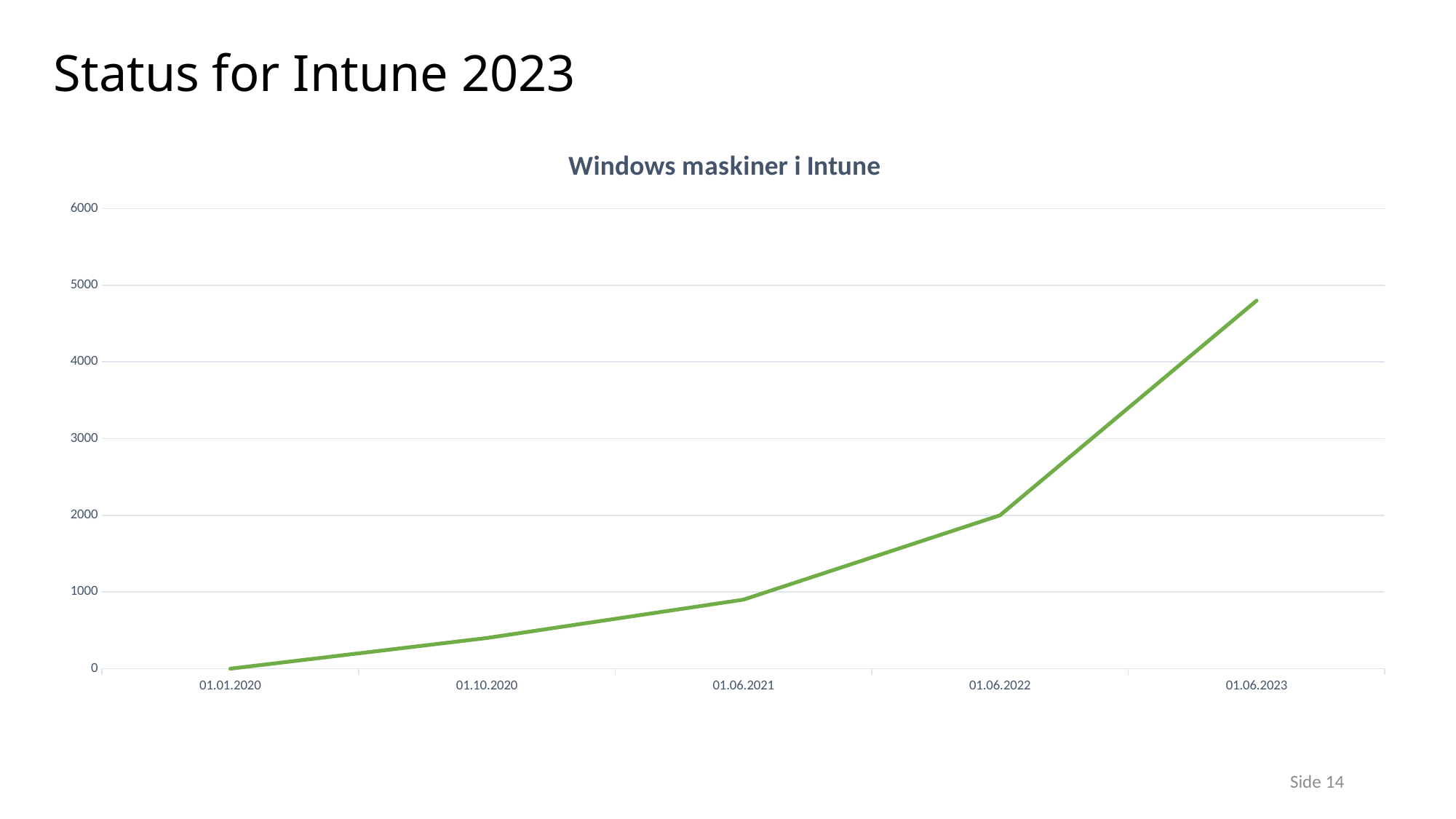
Which is larger, the value for 01.06.2022 or the value for 01.06.2021? 01.06.2022 Which date has the highest value on the chart? 01.06.2023 What kind of chart is shown on the slide? line chart Is the value for 01.06.2021 greater or less than 1000? less Is the value for 01.10.2020 greater or less than 1000? less Is the value for 01.06.2022 greater or less than 1000? greater How many dates are labelled on the x axis of the chart? 5 Do the values rise or fall from 01.01.2020 to 01.06.2023? rise What is the title of the chart? Windows maskiner i Intune Which date has the lowest value on the chart? 01.01.2020